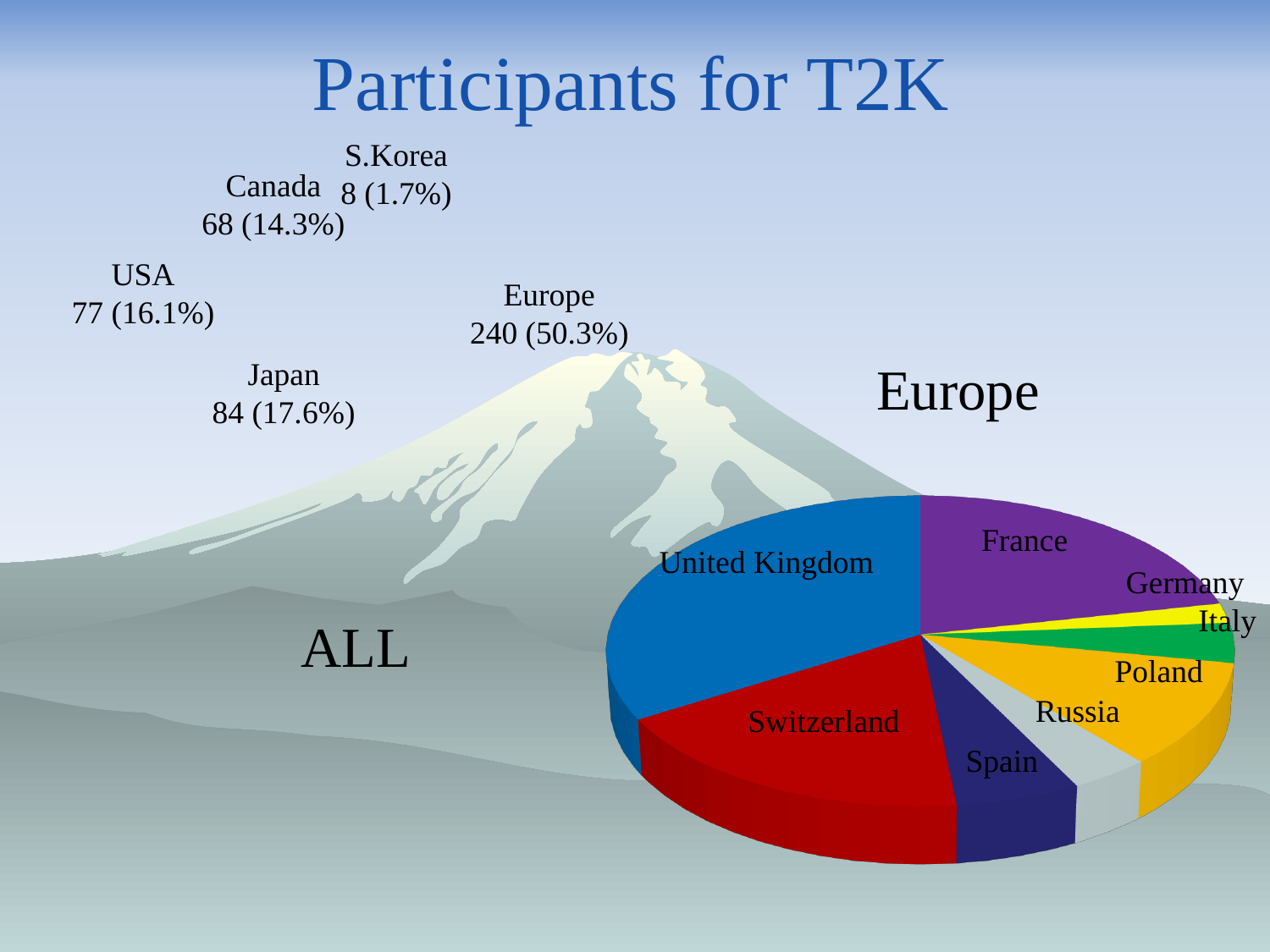
In the ALL chart, what percentage of participants are from Japan? 17.6% In the ALL chart, what is the difference between the number of participants from Japan and from the USA? 7 In the ALL chart, what is the total number of participants across all labelled categories? 477 In the ALL chart, which has more participants, Canada or the USA? USA In the Europe pie chart, which slice is larger, France or Spain? France What kind of chart is the Europe chart? pie chart In the ALL chart, how many participants are from Europe? 240 How many slices does the Europe pie chart have? 8 In the ALL chart, what share of participants does Europe account for? 50.3% In the ALL chart, which region has the most participants? Europe In the ALL chart, which country has the fewest participants? S.Korea How many categories are labelled in the ALL chart? 5